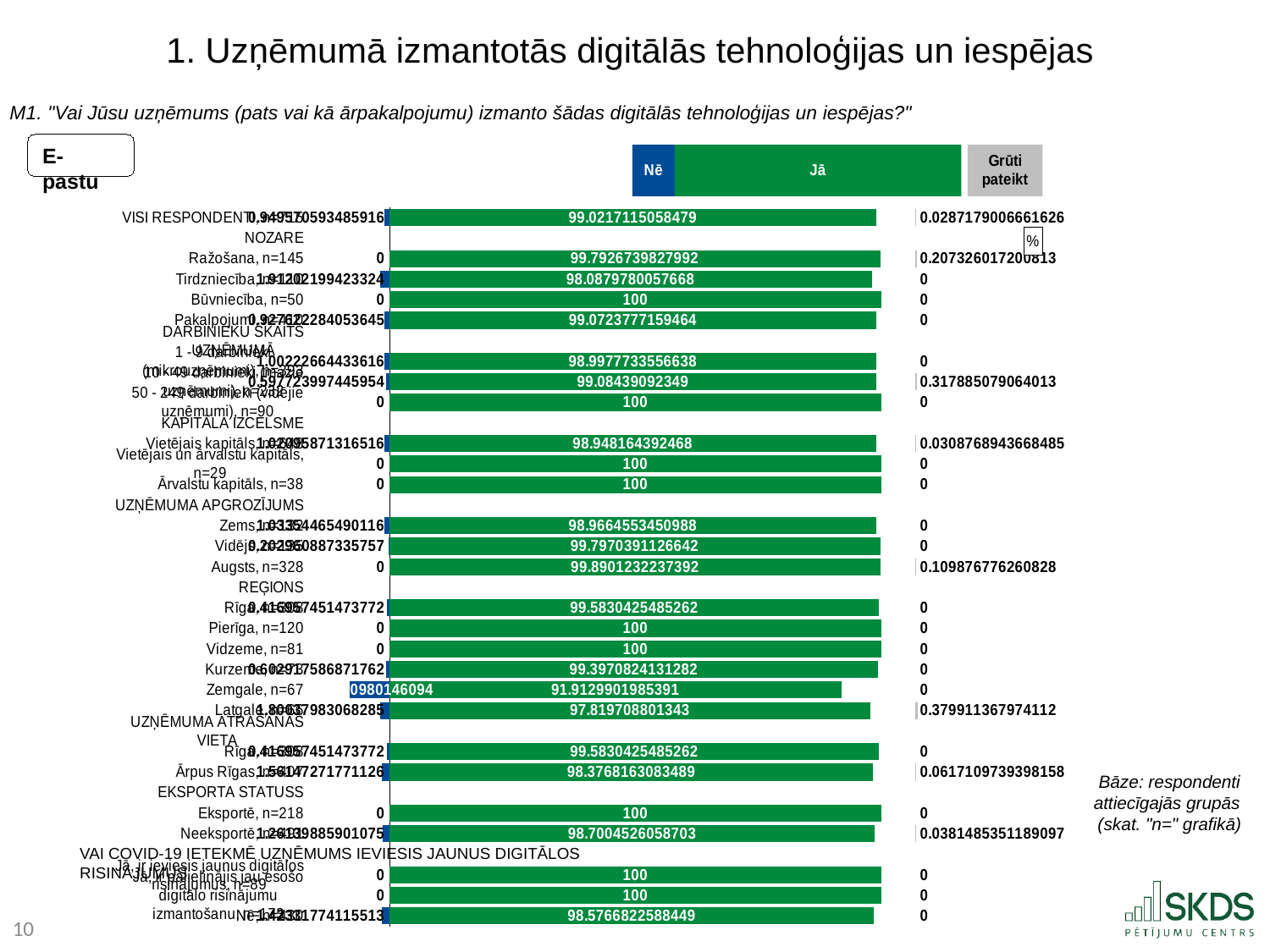
What is the difference between the "Jā" values for Pierīga, n=120 and Zemgale, n=67? 8.0870098014609 What is the value of the "Jā" series for Būvniecība, n=50? 100 What is the value of the "Grūti pateikt" series for Eksportē, n=218? 0 What kind of chart is shown on the slide? Stacked bar chart What are the three legend entries of the chart? Nē, Jā, Grūti pateikt Among the regions (Rīga, Pierīga, Vidzeme, Kurzeme, Zemgale, Latgale), which has the lowest "Jā" value? Zemgale, n=67 What is the value of the "Jā" series for Augsts, n=328? 99.8901232237392 What is the value of the "Jā" series for Vidzeme, n=81? 100 What is the value of the "Jā" series for Zemgale, n=67? 91.9129901985391 Which has the larger "Jā" value: Zemgale, n=67 or Pierīga, n=120? Pierīga, n=120 How many series does the chart legend list? 3 What is the value of the "Grūti pateikt" series for Latgale? 0.379911367974112